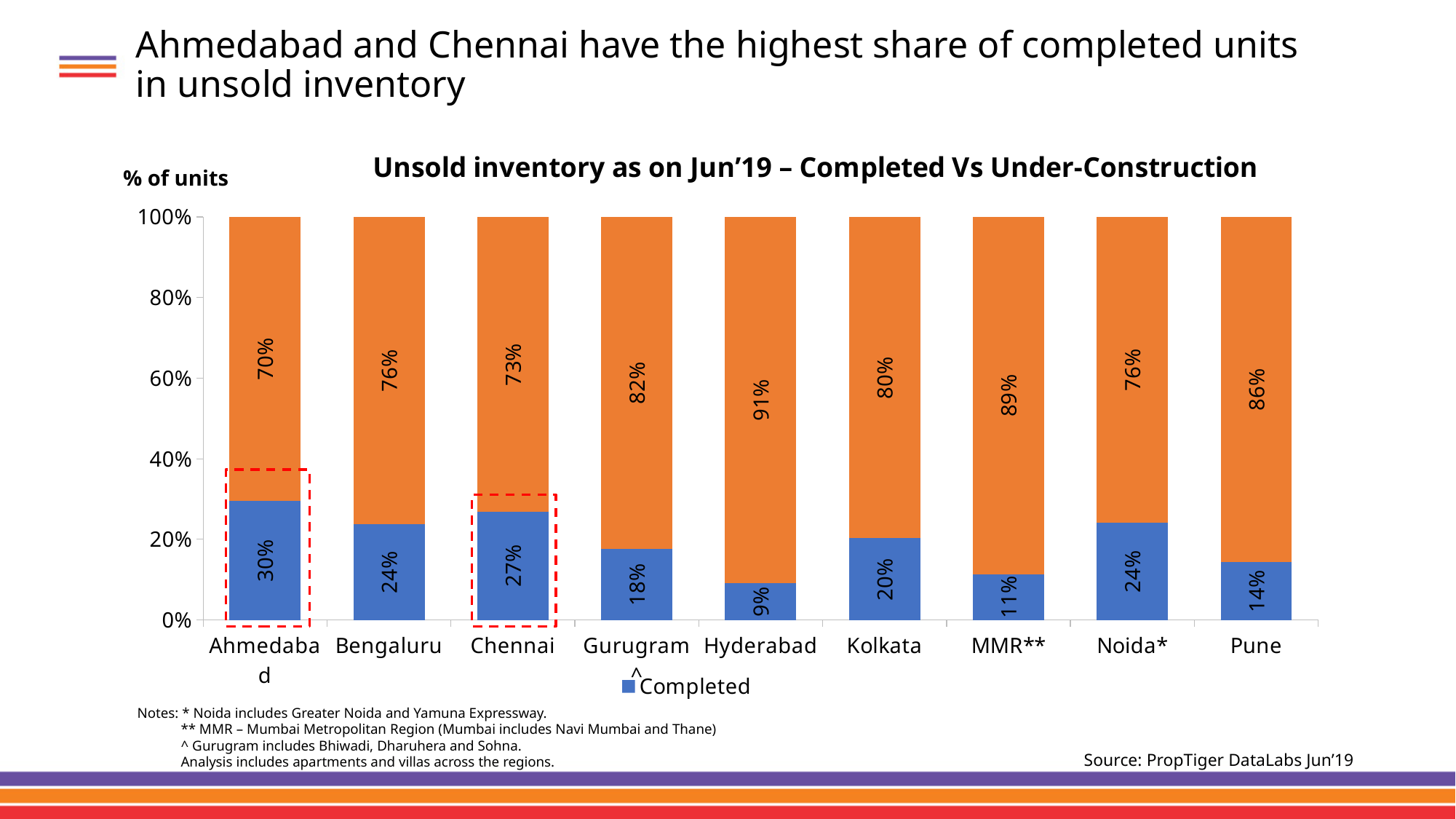
Which colour represents the Completed series in the chart? Blue What is the completed share of unsold inventory for Kolkata? 20% What is the difference between the completed shares of Ahmedabad and Chennai? 3% What is the under-construction share of unsold inventory for Hyderabad? 91% Is the completed share for MMR** greater or less than 20%? less Which city has the lowest completed share of unsold inventory? Hyderabad How many cities are shown on the chart? 9 Which has a larger completed share of unsold inventory, Gurugram or Pune? Gurugram Which city has the highest completed share of unsold inventory? Ahmedabad What is the title of the chart? Unsold inventory as on Jun’19 – Completed Vs Under-Construction What kind of chart is shown on the slide? Stacked bar chart What is the completed share of unsold inventory for Ahmedabad? 30%